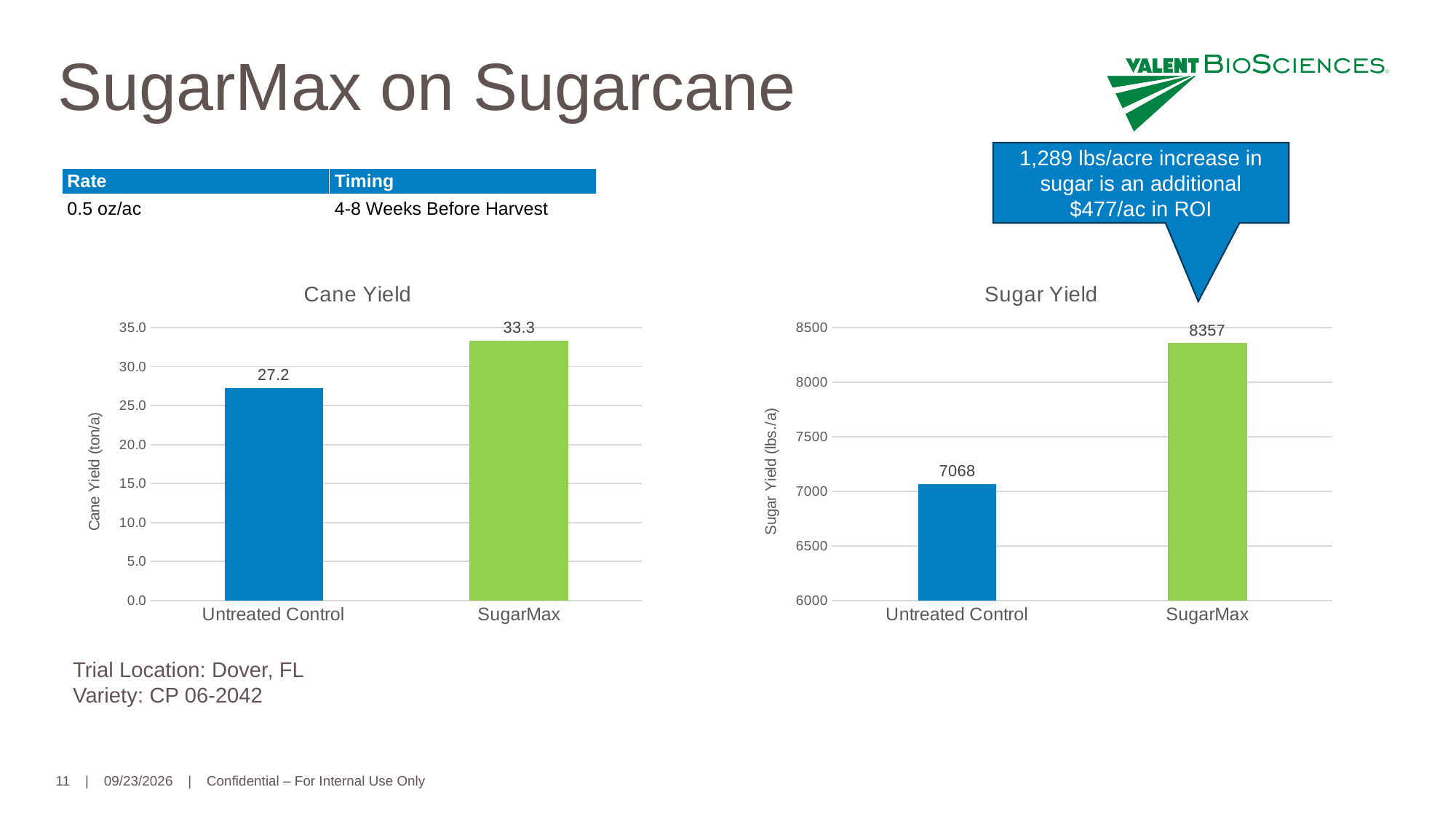
How many categories are shown in the Cane Yield chart? 2 In the Sugar Yield chart, is the value for Untreated Control greater or less than 7500? less In the Sugar Yield chart, what is the value for Untreated Control? 7068 In the Sugar Yield chart, what is the value for SugarMax? 8357 What kind of chart is the Sugar Yield chart? bar chart In the Sugar Yield chart, what is the difference between the SugarMax and Untreated Control values? 1289 In the Cane Yield chart, what is the value for Untreated Control? 27.2 What is the y-axis label of the Cane Yield chart? Cane Yield (ton/a) In the Cane Yield chart, what is the value for SugarMax? 33.3 In the Sugar Yield chart, which category has the lowest value? Untreated Control In the Cane Yield chart, what is the difference between the SugarMax and Untreated Control values? 6.1 In the Cane Yield chart, which category has the highest value? SugarMax